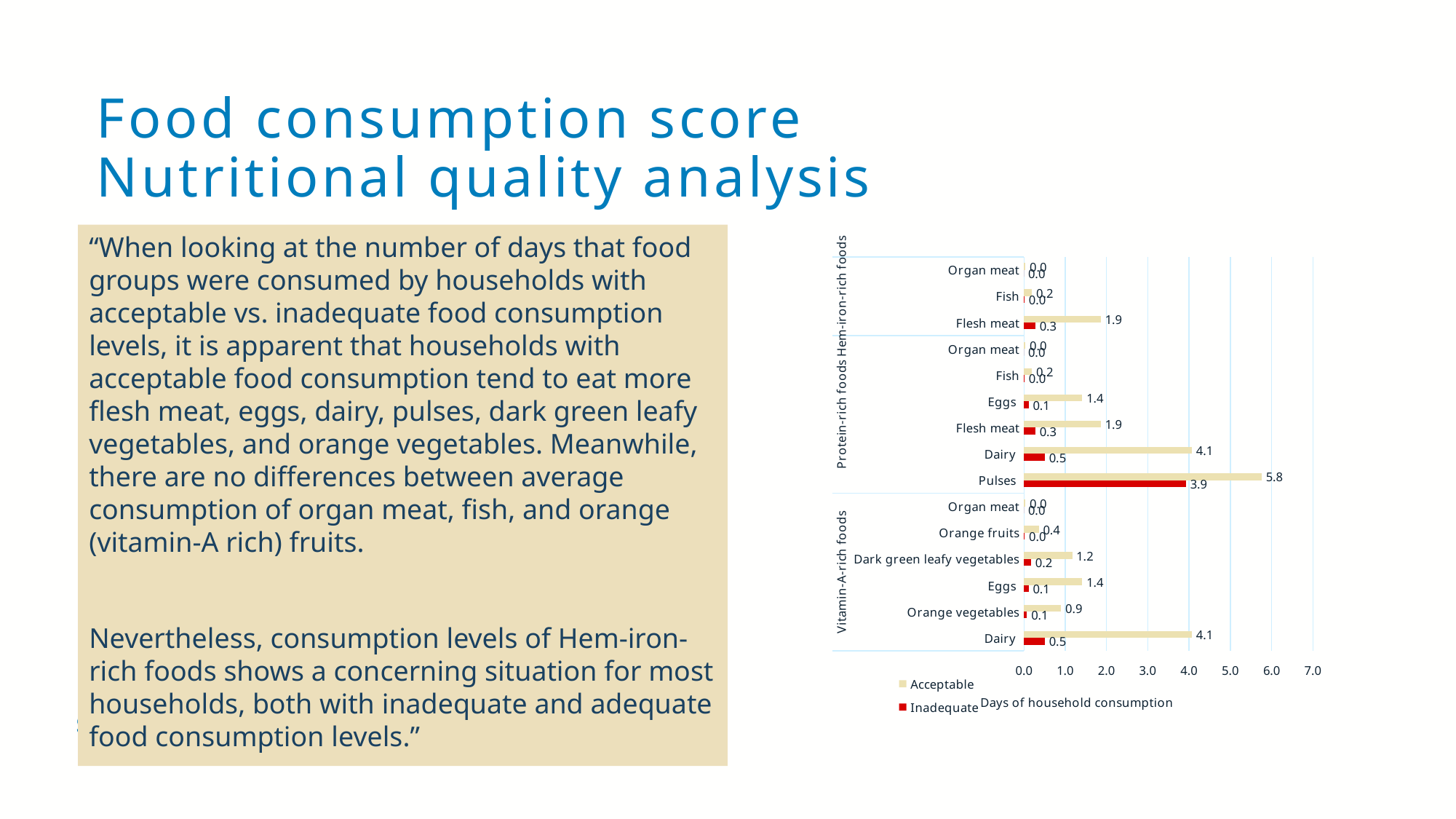
What kind of chart is shown on the slide? Bar chart How many series does the legend list? 2 What is the Acceptable value for Pulses in the Protein-rich foods group? 5.8 What is the Acceptable value for Dairy in the Vitamin-A-rich foods group? 4.1 What is the label of the horizontal axis of the chart? Days of household consumption What is the Inadequate value for Pulses in the Protein-rich foods group? 3.9 Which food item has the highest Acceptable value on the chart? Pulses What is the difference between the Acceptable and Inadequate values for Pulses? 1.9 How many food item bars are plotted on the chart in total? 15 Which is larger, the Acceptable value for Eggs or the Acceptable value for Orange vegetables in the Vitamin-A-rich foods group? Eggs What is the difference between the Acceptable values for Dairy and Flesh meat in the Protein-rich foods group? 2.2 What is the Inadequate value for Dark green leafy vegetables? 0.2